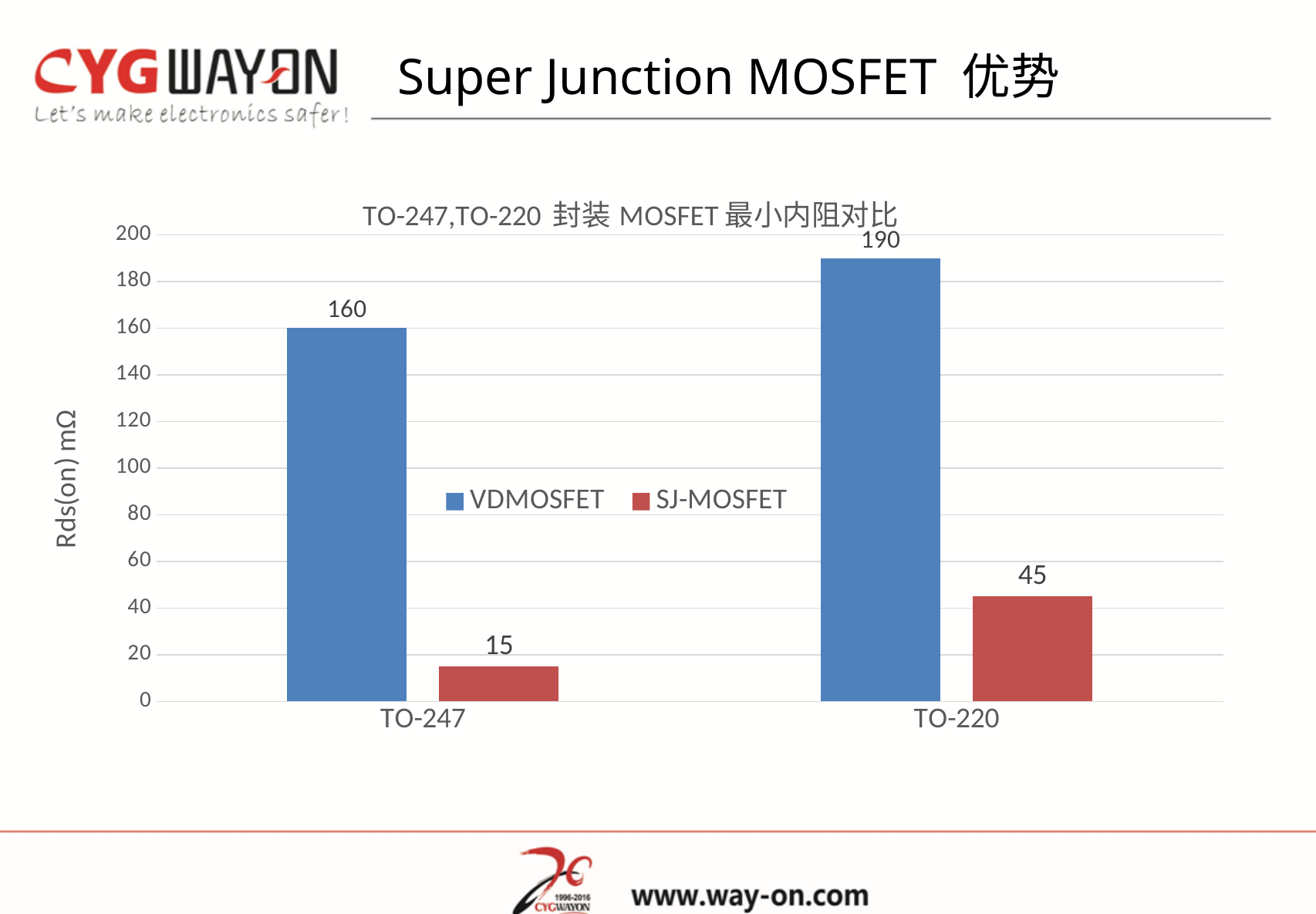
What is the Rds(on) value for VDMOSFET in the TO-247 package? 160 How many series does the legend list? 2 What is the label of the vertical axis? Rds(on) mΩ What is the difference between the VDMOSFET and SJ-MOSFET values for TO-220? 145 What kind of chart is shown on the slide? Bar chart What is the difference between the VDMOSFET values for TO-220 and TO-247? 30 Which bar has the highest value on the chart? VDMOSFET, TO-220 How many package categories are shown on the x axis? 2 Which bar has the lowest value on the chart? SJ-MOSFET, TO-247 What is the Rds(on) value for SJ-MOSFET in the TO-247 package? 15 Which is larger, the SJ-MOSFET value for TO-247 or for TO-220? TO-220 What is the Rds(on) value for SJ-MOSFET in the TO-220 package? 45